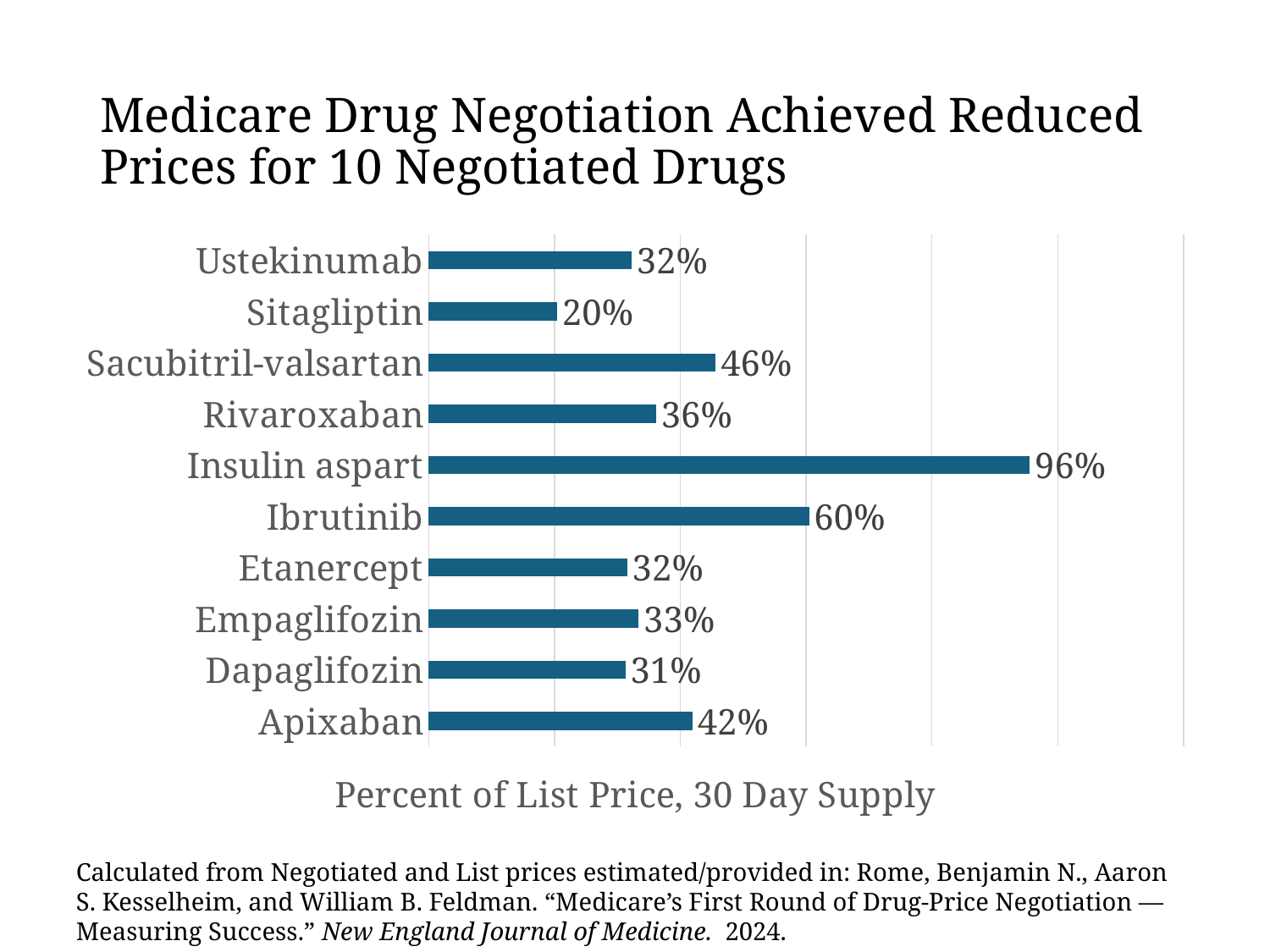
What kind of chart is shown on the slide? Bar chart Which drug has the highest percent of list price? Insulin aspart What is the title of the chart on the slide? Medicare Drug Negotiation Achieved Reduced Prices for 10 Negotiated Drugs How many drugs are shown in the chart? 10 What is the value for Sacubitril-valsartan? 46% Which is larger, the value for Sacubitril-valsartan or the value for Apixaban? Sacubitril-valsartan What is the value for Insulin aspart? 96% What is the value for Apixaban? 42% What is the x-axis label of the chart? Percent of List Price, 30 Day Supply Which drug has the lowest percent of list price? Sitagliptin What is the difference between the values for Ibrutinib and Rivaroxaban? 24% What is the value for Sitagliptin? 20%